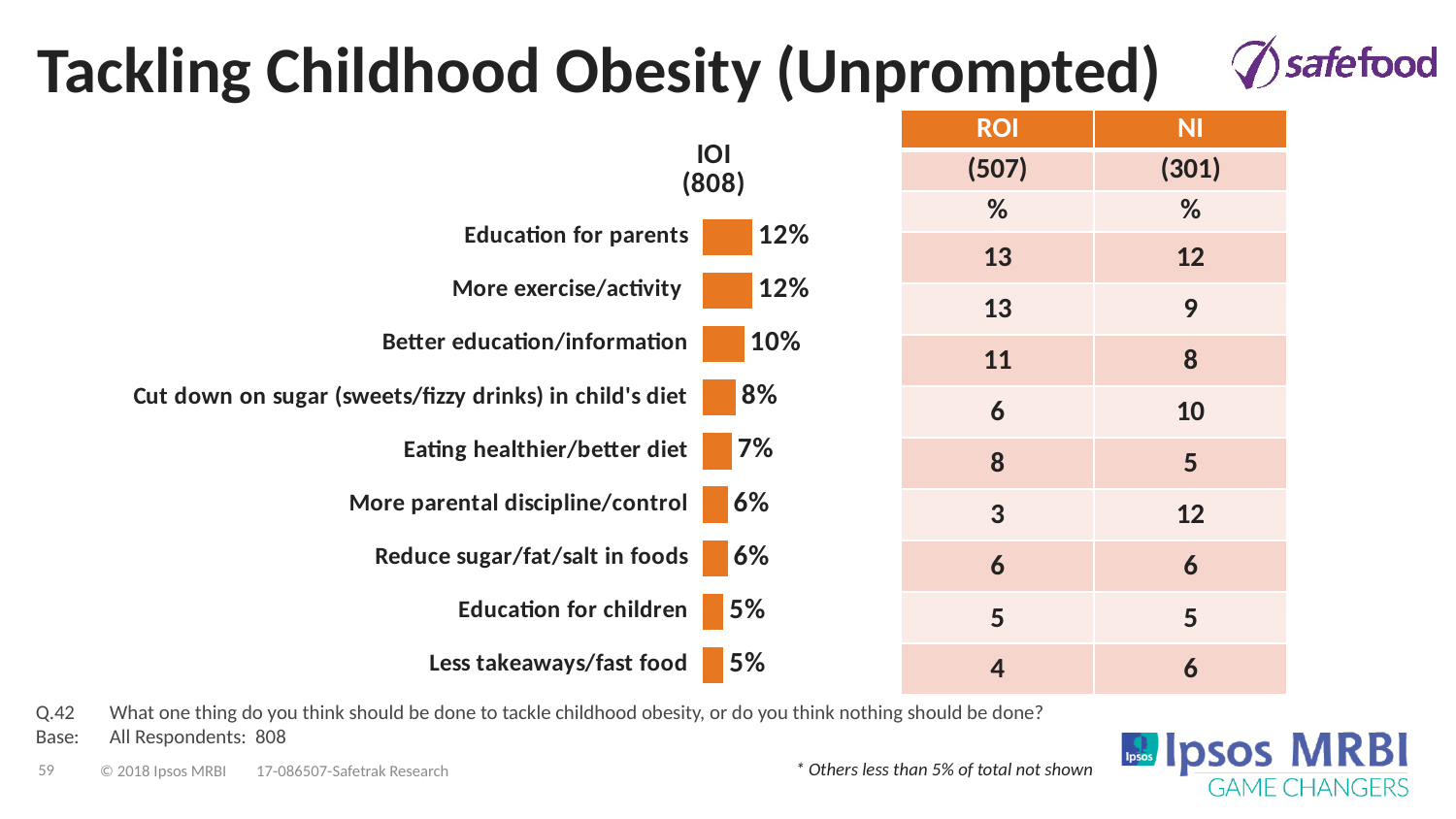
What is the value for Less takeaways/fast food in the bar chart? 5% What is the value for Cut down on sugar (sweets/fizzy drinks) in child's diet in the bar chart? 8% How many categories are shown in the bar chart? 9 What is the value for Education for parents in the bar chart? 12% What is the value for Better education/information in the bar chart? 10% What is the base size shown above the bar chart for IOI? 808 What is the value for Eating healthier/better diet in the bar chart? 7% Which has a larger value in the bar chart: Cut down on sugar (sweets/fizzy drinks) in child's diet or Reduce sugar/fat/salt in foods? Cut down on sugar (sweets/fizzy drinks) in child's diet What is the difference between the values for More exercise/activity and Eating healthier/better diet in the bar chart? 5 percentage points What kind of chart is shown on the slide? Bar chart What is the difference between the values for Better education/information and Education for children in the bar chart? 5 percentage points Which has a larger value in the bar chart: Better education/information or More parental discipline/control? Better education/information